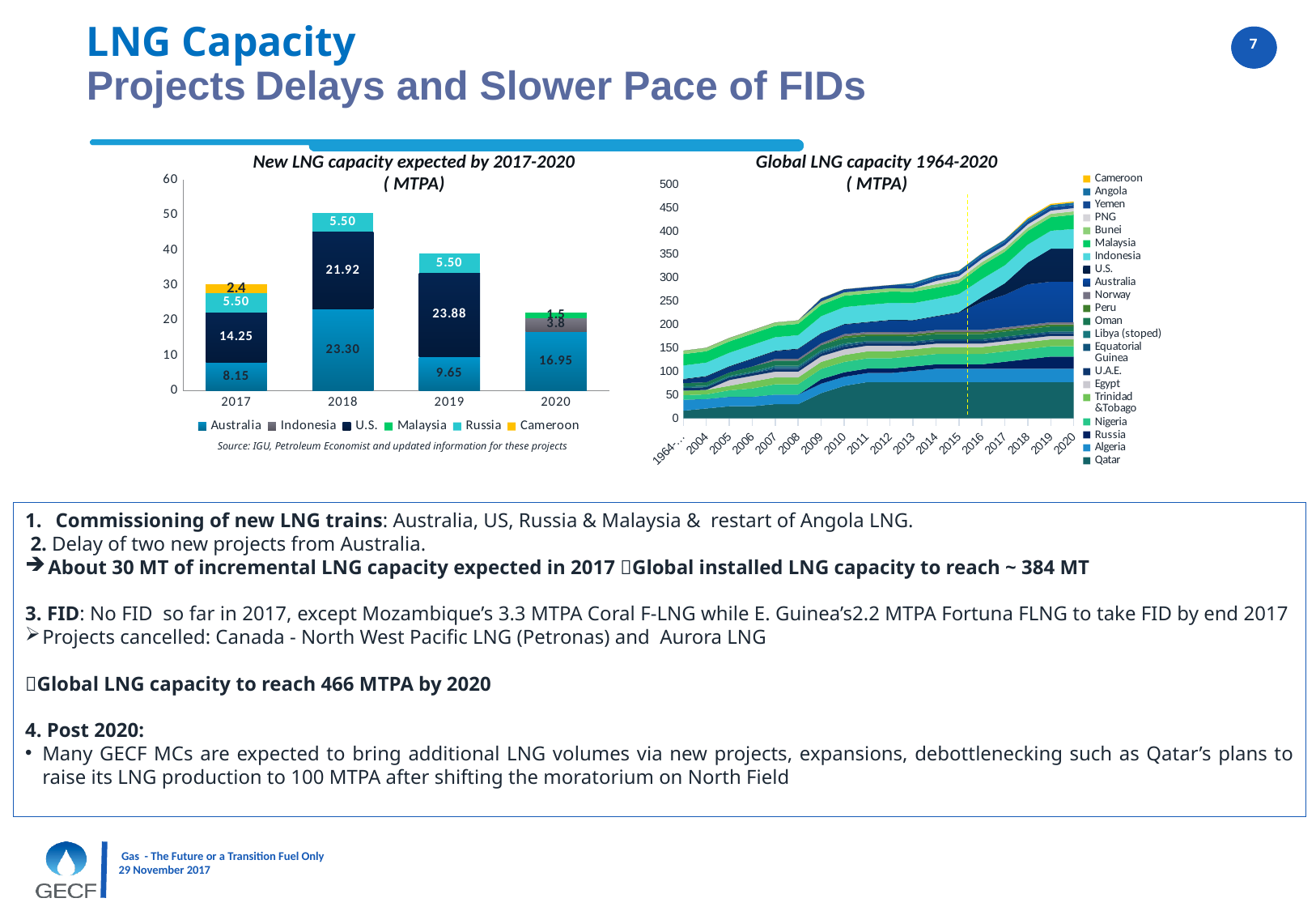
In the left chart 'New LNG capacity expected by 2017-2020', what is the value for Australia in 2018? 23.30 How many series does the legend of the left chart 'New LNG capacity expected by 2017-2020' list? 6 In the left chart 'New LNG capacity expected by 2017-2020', which year has the highest total new capacity? 2018 In the left chart 'New LNG capacity expected by 2017-2020', what is the value for Cameroon in 2017? 2.4 In the left chart 'New LNG capacity expected by 2017-2020', which year has the lowest total new capacity? 2020 What kind of chart is the right chart, 'Global LNG capacity 1964-2020 (MTPA)'? Stacked area chart In the right chart 'Global LNG capacity 1964-2020', is the total capacity in 2020 greater or less than 400? greater In the left chart 'New LNG capacity expected by 2017-2020', what is the total of the stacked bar for 2017? 30.3 What kind of chart is the left chart, 'New LNG capacity expected by 2017-2020 (MTPA)'? Stacked bar chart How many years are shown on the x axis of the left chart 'New LNG capacity expected by 2017-2020'? 4 In the left chart 'New LNG capacity expected by 2017-2020', what is the difference between the U.S. value in 2019 and the U.S. value in 2018? 1.96 In the left chart 'New LNG capacity expected by 2017-2020', what is the value for U.S. in 2019? 23.88